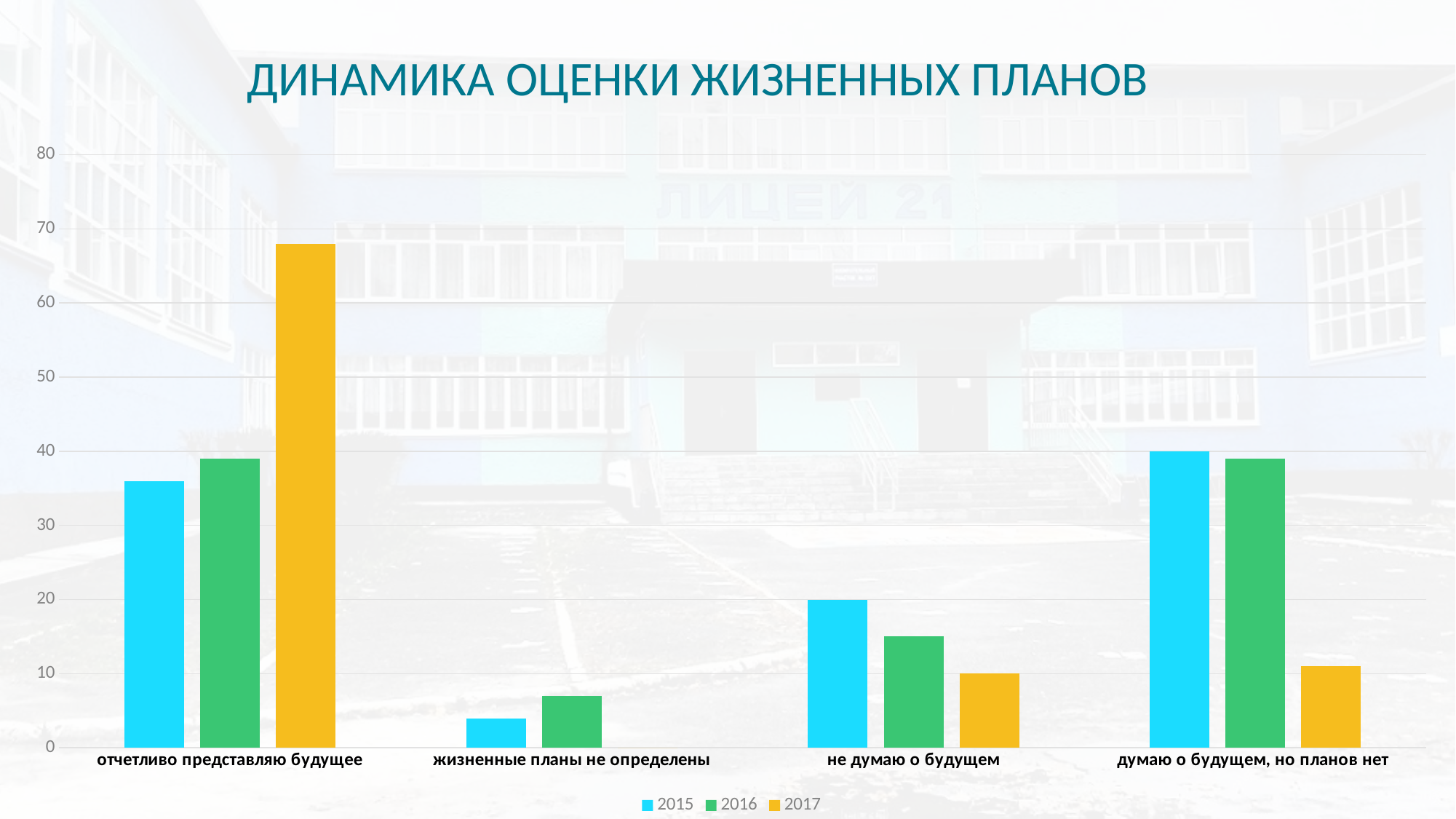
Which year and category has the shortest visible bar in the chart? 2015, жизненные планы не определены Which year and category has the tallest bar in the chart? 2017, отчетливо представляю будущее Is the 2016 value for 'жизненные планы не определены' greater or less than 10? less What kind of chart is shown on the slide? bar chart How many categories are shown on the x axis? 4 For 'отчетливо представляю будущее', which is larger: the 2015 value or the 2017 value? 2017 Do the values for 'отчетливо представляю будущее' rise or fall from 2015 to 2017? rise Is the 2017 value for 'думаю о будущем, но планов нет' greater or less than 20? less How many series does the legend list? 3 Is the 2017 value for 'отчетливо представляю будущее' greater or less than 60? greater For 'думаю о будущем, но планов нет', which is larger: the 2015 value or the 2017 value? 2015 What is the title of the chart? ДИНАМИКА ОЦЕНКИ ЖИЗНЕННЫХ ПЛАНОВ